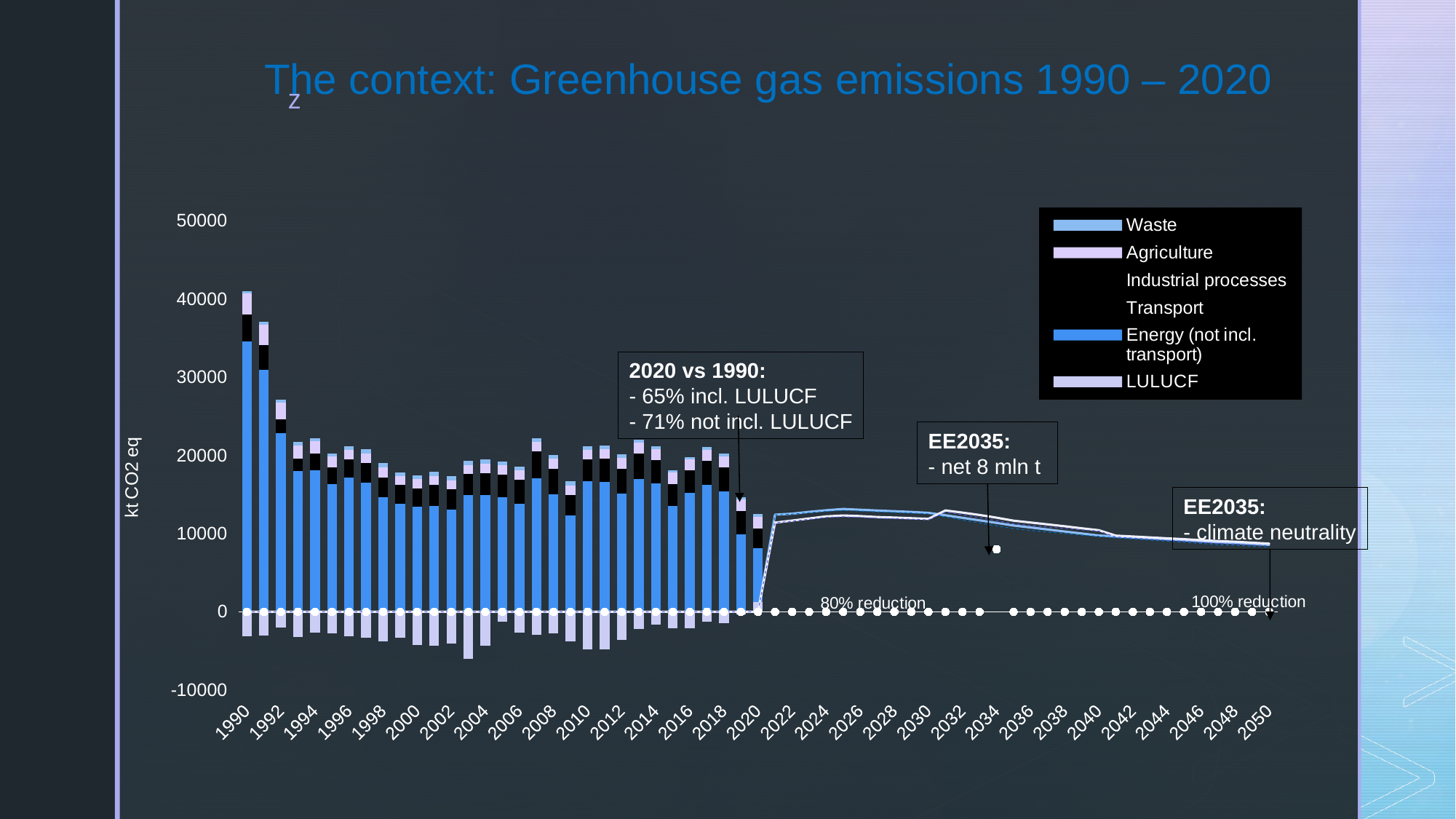
Among the bars from 1990 to 2020, which year has the lowest total emissions above zero? 2020 Is the total emissions value for 2020 greater or less than 20000? less What is the label on the vertical axis of the chart? kt CO2 eq How many series does the legend list? 6 Which year has the larger total emissions bar, 1990 or 2000? 1990 Is the total emissions value for 1990 greater or less than 30000? greater What type of chart is shown on the slide? bar and line chart Which year has the larger total emissions bar, 2008 or 2009? 2008 Is the total emissions value for 2020 greater or less than 10000? greater Do the total emissions generally rise or fall from 1990 to 2020? fall Which year has the highest total emissions bar? 1990